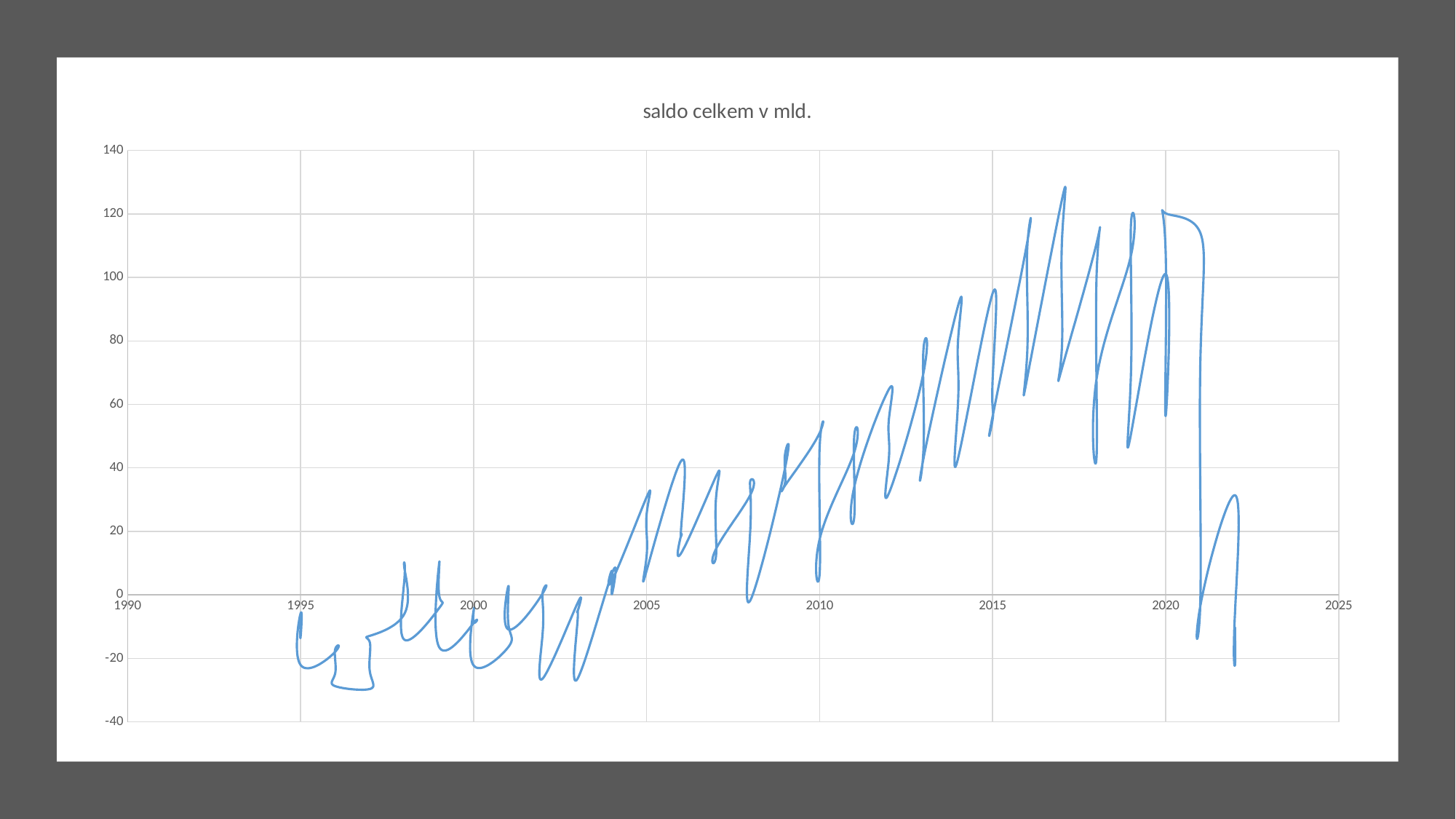
Is the lowest point of the line, reached around 1996–1997, greater or less than -20? less Is the highest peak of the line, reached around 2017, greater or less than 120? greater Is the peak of the line near 2010 greater or less than 40? greater What is the highest value labelled on the vertical axis? 140 Does the overall level of the line rise or fall between 1995 and 2020? rise What kind of chart is shown on the slide? line chart What is the title of the chart? saldo celkem v mld.